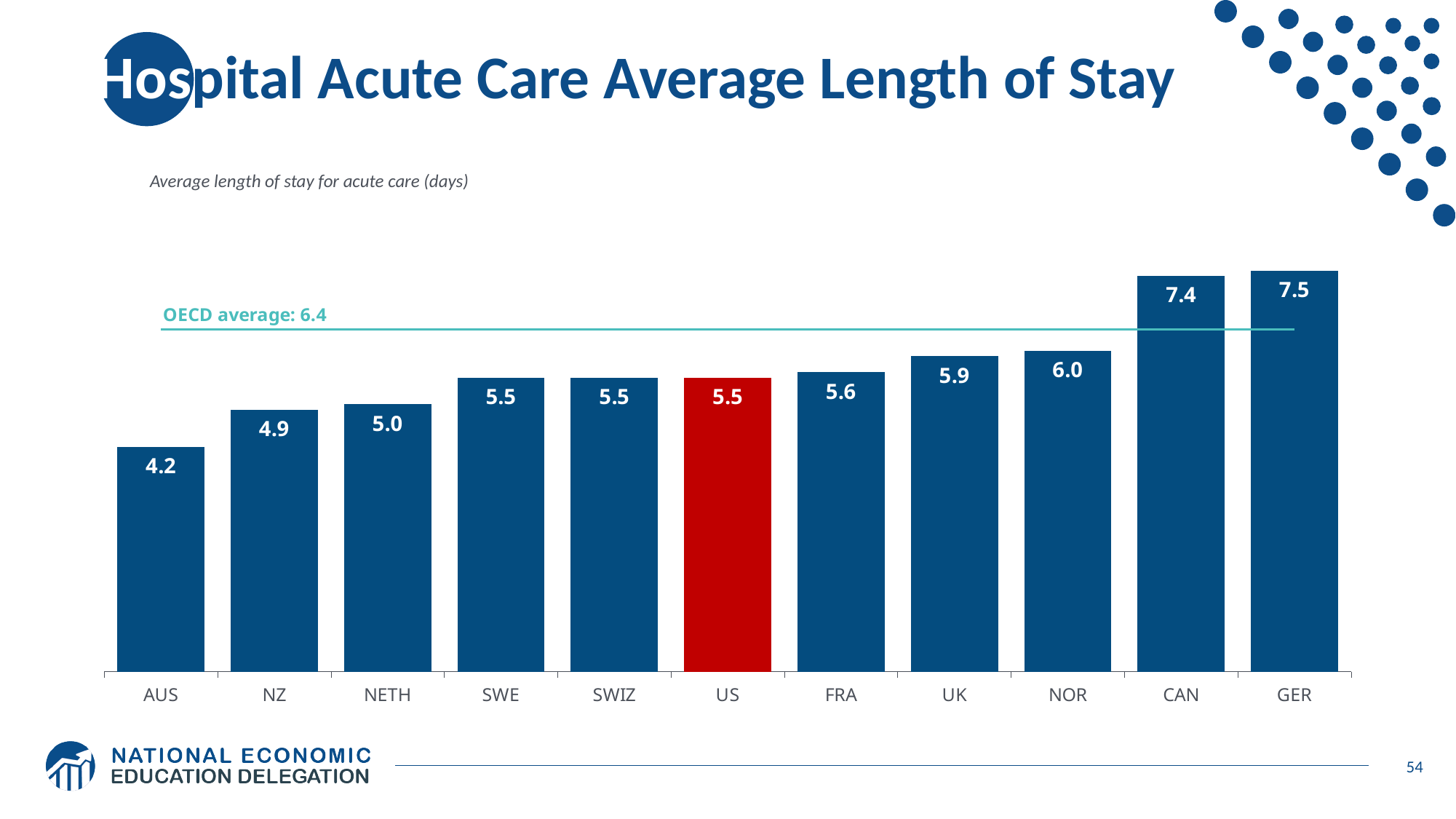
Do the values generally rise or fall from left to right across the countries? Rise Which has a longer average length of stay, NOR or NZ? NOR What is the average length of stay for acute care in Germany (GER)? 7.5 How many countries are shown in the chart? 11 What is the difference in average length of stay between GER and AUS? 3.3 What is the difference in average length of stay between CAN and the US? 1.9 What is the average length of stay for acute care in Australia (AUS)? 4.2 What is the average length of stay for acute care in the US? 5.5 What kind of chart is shown on the slide? Bar chart Which country has the highest average length of stay for acute care? GER Which country has the lowest average length of stay for acute care? AUS What is the OECD average length of stay shown by the horizontal line? 6.4